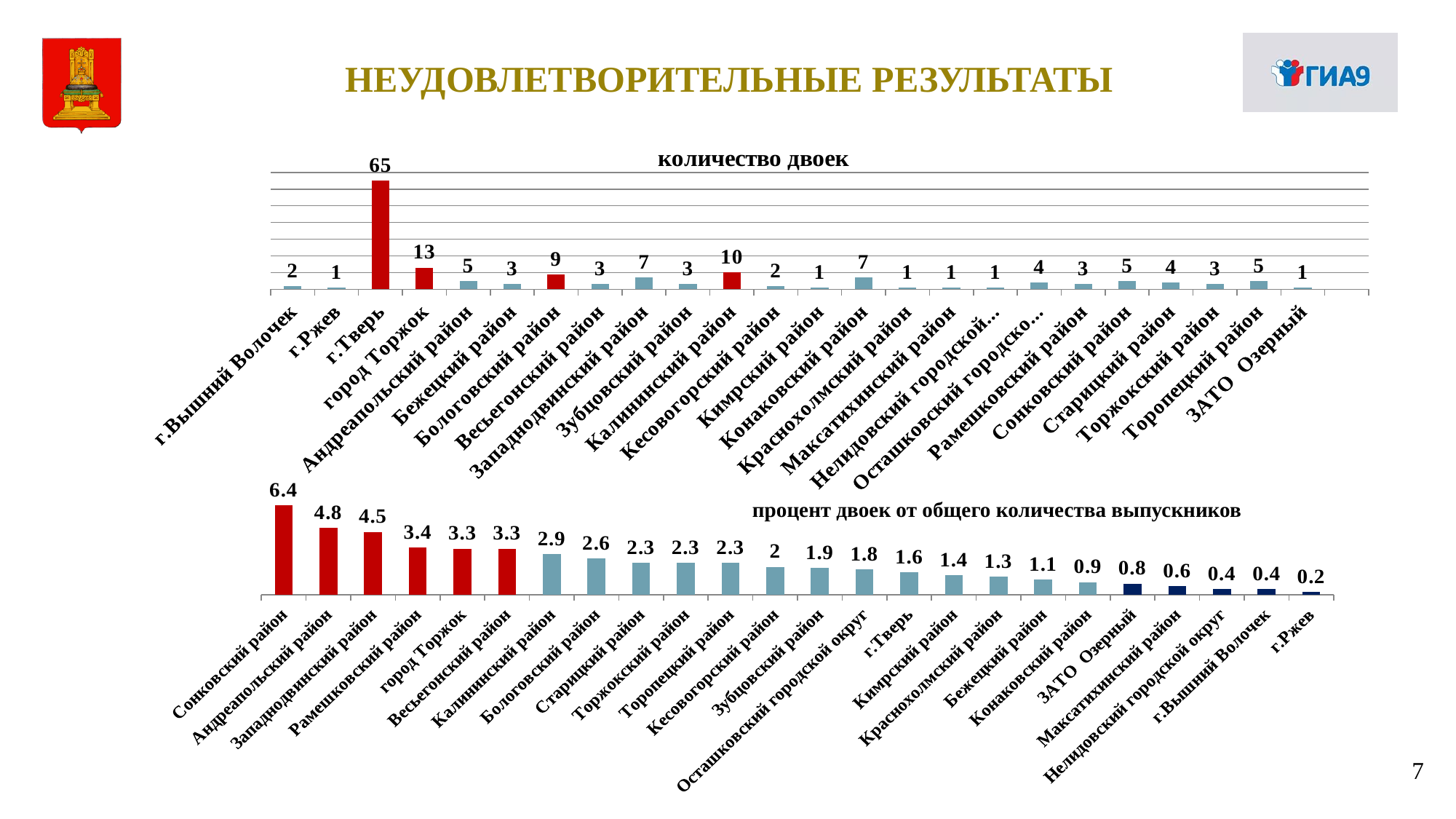
In the chart titled «процент двоек от общего количества выпускников», what is the value for г.Тверь? 1.6 In the chart titled «процент двоек от общего количества выпускников», what is the difference between the values for Сонковский район and Андреапольский район? 1.6 In the chart titled «количество двоек», which is larger: the value for Бологовский район or the value for Западнодвинский район? Бологовский район In the chart titled «количество двоек», which category has the highest value? г.Тверь In the chart titled «количество двоек», how many categories are shown? 24 In the chart titled «количество двоек», what is the difference between the values for г.Тверь and город Торжок? 52 In the chart titled «количество двоек», what is the value for Калининский район? 10 In the chart titled «процент двоек от общего количества выпускников», which category has the lowest value? г.Ржев In the chart titled «процент двоек от общего количества выпускников», do the values rise or fall from left to right? fall In the chart titled «процент двоек от общего количества выпускников», what is the value for Сонковский район? 6.4 In the chart titled «количество двоек», what is the value for г.Тверь? 65 What kind of chart is the bottom chart on the slide? bar chart